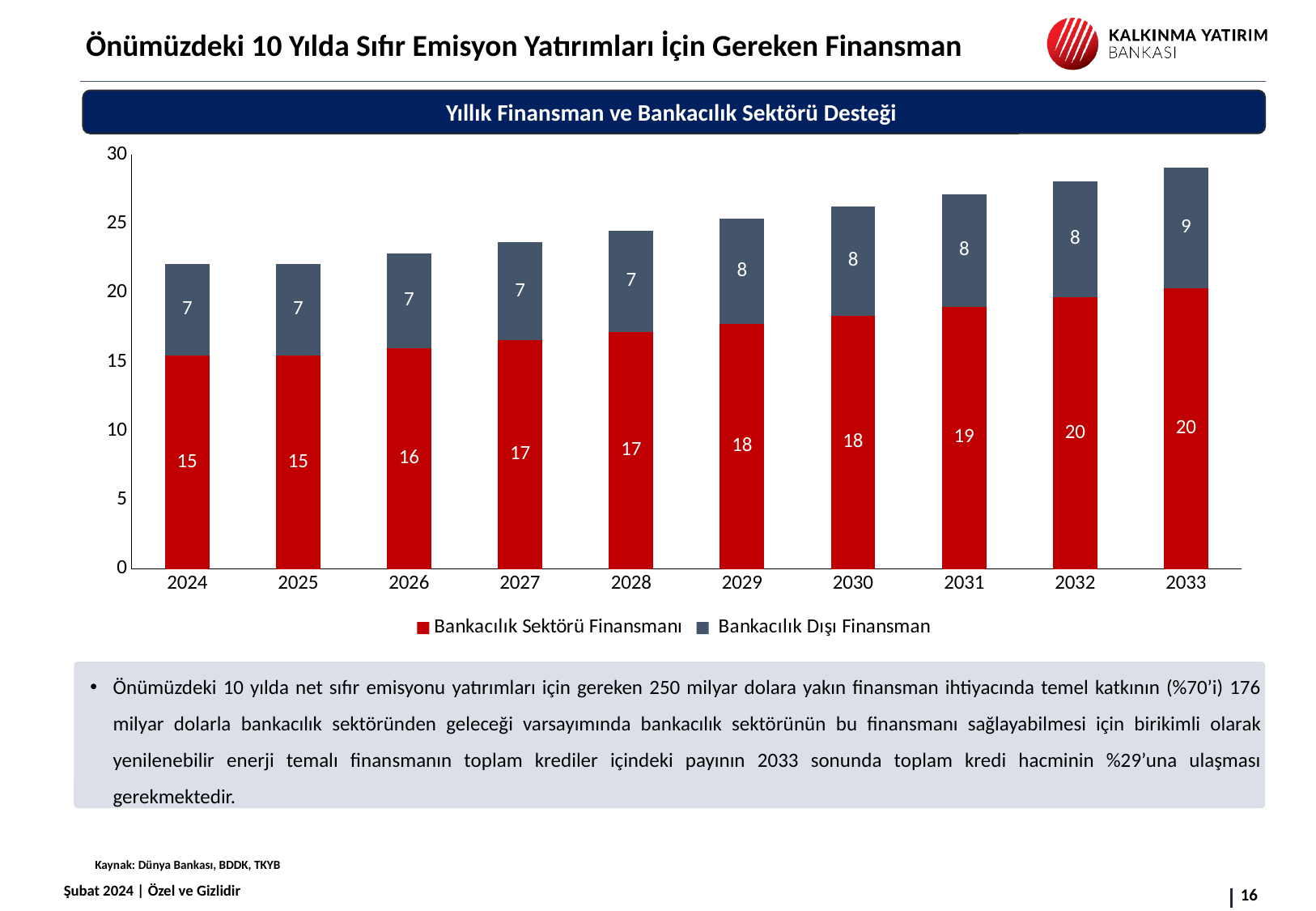
How many series does the legend list? 2 Is the total height of the stacked bar for 2033 greater or less than 25? greater What is the value of Bankacılık Dışı Finansman for 2033? 9 Do the Bankacılık Sektörü Finansmanı values rise or fall from 2024 to 2033? Rise What is the difference between the Bankacılık Sektörü Finansmanı values for 2033 and 2024? 5 What is the total of the stacked bar for 2032? 28 What is the value of Bankacılık Sektörü Finansmanı for 2031? 19 In 2029, which is larger: Bankacılık Sektörü Finansmanı or Bankacılık Dışı Finansman? Bankacılık Sektörü Finansmanı How many years are shown on the x axis? 10 What is the value of Bankacılık Sektörü Finansmanı for 2024? 15 What kind of chart is shown on the slide? Stacked bar chart Which year has the highest value for Bankacılık Dışı Finansman? 2033